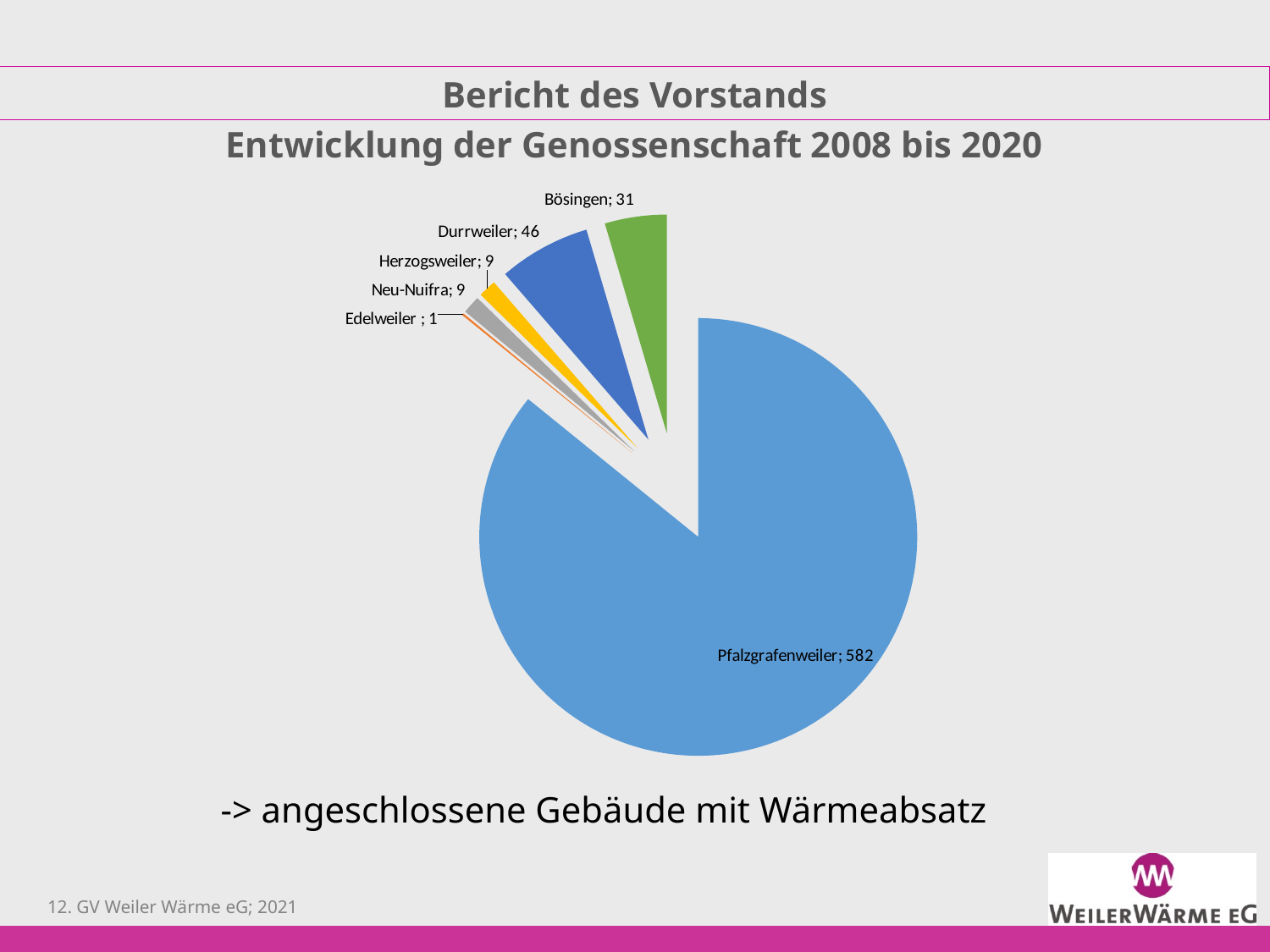
What value is shown for Bösingen in the pie chart? 31 What is the total of all the values shown in the pie chart? 678 Which is larger, the value for Durrweiler or the value for Bösingen? Durrweiler How many slices does the pie chart have? 6 Which category has the smallest slice in the pie chart? Edelweiler What is the title of the slide above the chart? Entwicklung der Genossenschaft 2008 bis 2020 What value is shown for Pfalzgrafenweiler in the pie chart? 582 What value is shown for Durrweiler in the pie chart? 46 What kind of chart is shown on the slide? Pie chart What is the difference between the values for Durrweiler and Bösingen? 15 Which category has the largest slice in the pie chart? Pfalzgrafenweiler What value is shown for Edelweiler in the pie chart? 1